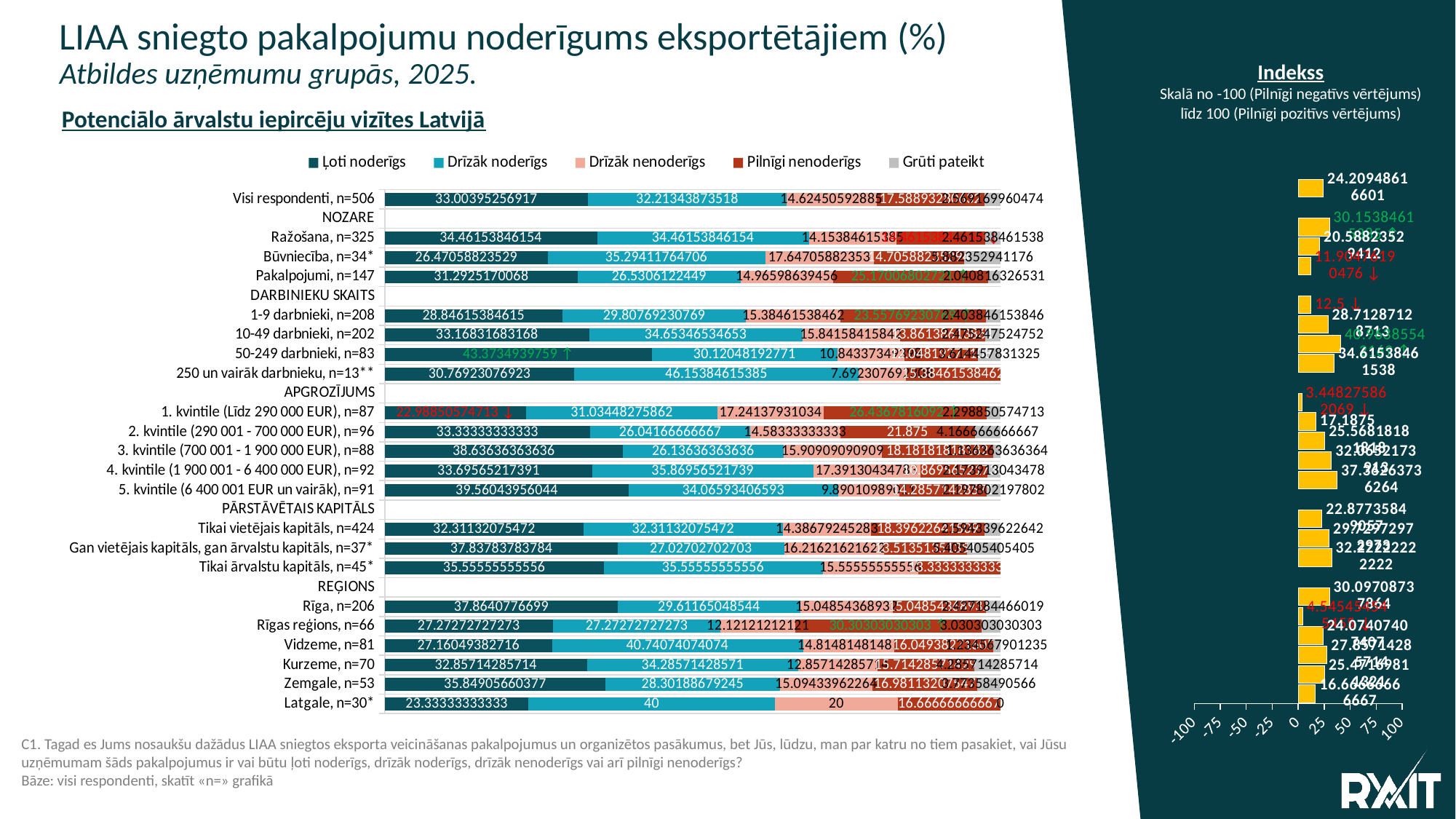
In the main chart, what is the 'Drīzāk noderīgs' value for 250 un vairāk darbinieku, n=13**? 46.15384615385 In the 'Indekss' chart on the right, which group has the highest index value? 50-249 darbinieki, n=83 How many series does the legend of the main chart list? 5 What kind of chart is the main chart on the left, 'Potenciālo ārvalstu iepircēju vizītes Latvijā'? Stacked bar chart In the 'Indekss' chart on the right, what is the index value for 1-9 darbinieki, n=208? 12.5 In the main chart, what is the difference between the 'Drīzāk noderīgs' and 'Drīzāk nenoderīgs' values for Latgale, n=30*? 20 In the main chart, what is the 'Drīzāk noderīgs' value for Latgale, n=30*? 40 In the main chart, what is the 'Ļoti noderīgs' value for Visi respondenti, n=506? 33.00395256917 In the main chart, for Vidzeme, n=81, which is larger: 'Ļoti noderīgs' or 'Drīzāk noderīgs'? Drīzāk noderīgs In the main chart, what is the 'Drīzāk nenoderīgs' value for Latgale, n=30*? 20 In the 'Indekss' chart on the right, is the index value for Pakalpojumi, n=147 greater or less than 25? less In the main chart, which group has the highest 'Ļoti noderīgs' value? 50-249 darbinieki, n=83